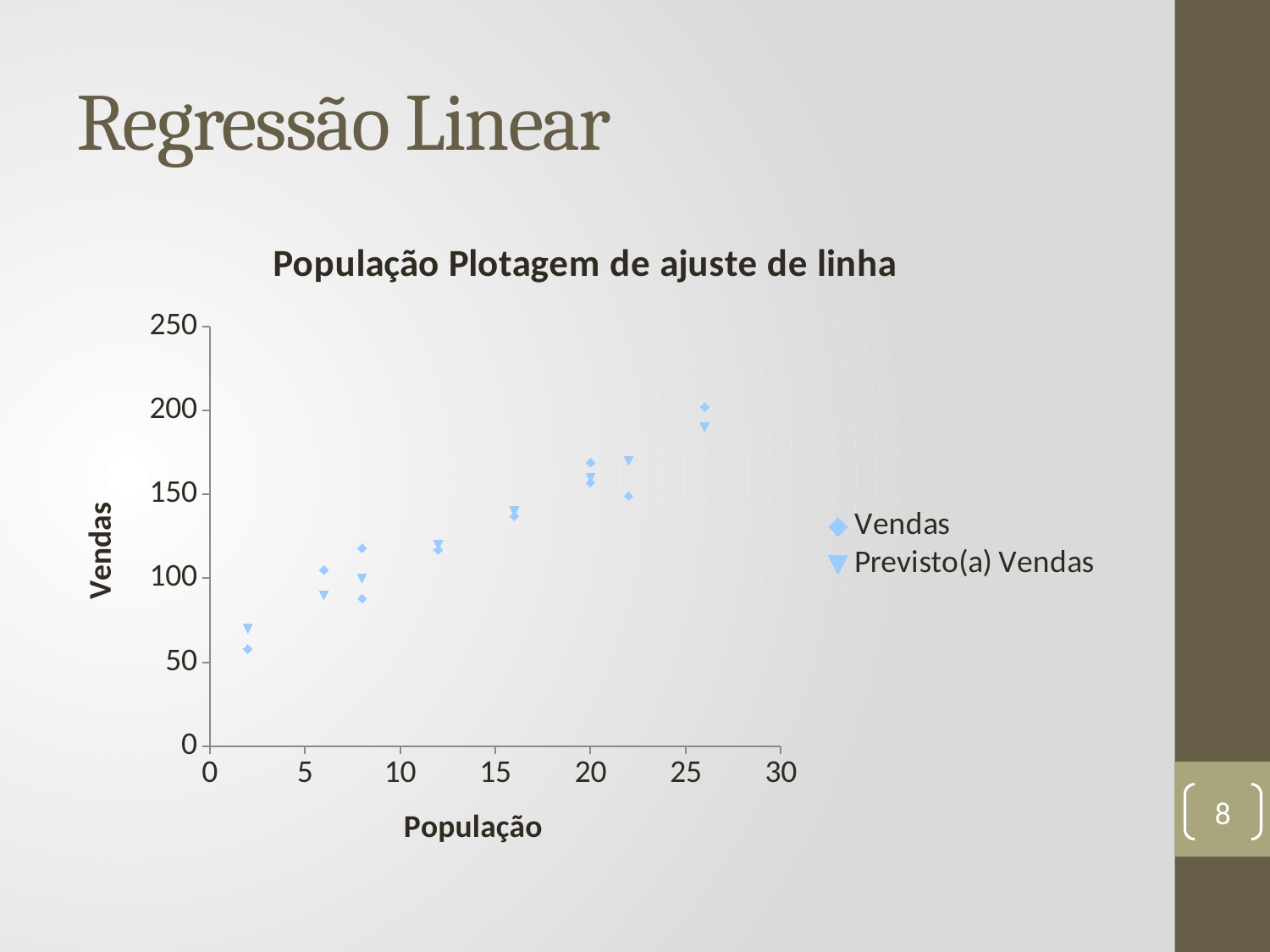
How many series does the chart legend list? 2 What is the title of the chart? População Plotagem de ajuste de linha At which População value does the Vendas series have its lowest point? 2 Is the Previsto(a) Vendas value at População 2 greater or less than 100? less Is the Vendas value at População 2 greater or less than 100? less What kind of chart is shown on the slide? scatter chart Is the Previsto(a) Vendas value at População 26 greater or less than 150? greater At which População value does the Vendas series reach its highest point? 26 Do the Previsto(a) Vendas values rise or fall as População increases along the x axis? rise What are the two series named in the chart legend? Vendas and Previsto(a) Vendas Do the Vendas values generally rise or fall as População increases along the x axis? rise